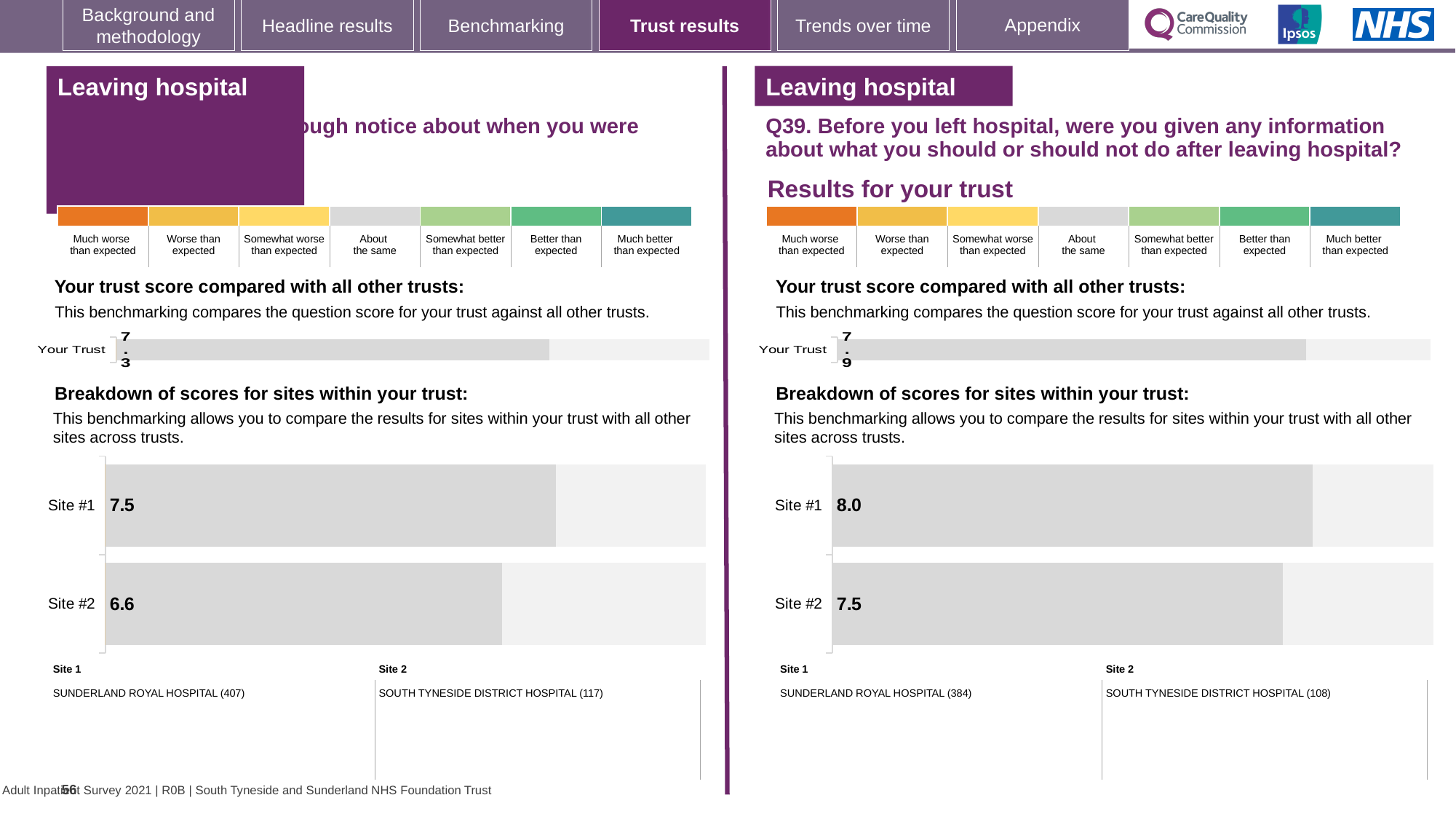
In the right-hand (Q39) site breakdown chart, what is the score for Site #1? 8.0 In the left-hand site breakdown chart, what is the score for Site #1? 7.5 In the left-hand site breakdown chart, what is the difference between the Site #1 and Site #2 scores? 0.9 In the right-hand (Q39) site breakdown chart, what is the score for Site #2? 7.5 On the right-hand side of the slide (Q39), what is the 'Your Trust' score shown in the trust benchmarking chart? 7.9 In the left-hand site breakdown chart, which site has the higher score? Site #1 In the right-hand (Q39) site breakdown chart, what is the difference between the Site #1 and Site #2 scores? 0.5 In the left-hand site breakdown chart, what is the score for Site #2? 6.6 How many sites are shown in the right-hand (Q39) site breakdown chart? 2 In the right-hand (Q39) site breakdown chart, which site has the lower score? Site #2 What type of chart is used for the site breakdown on the left-hand side of the slide? Bar chart On the left-hand side of the slide, what is the 'Your Trust' score shown in the trust benchmarking chart? 7.3